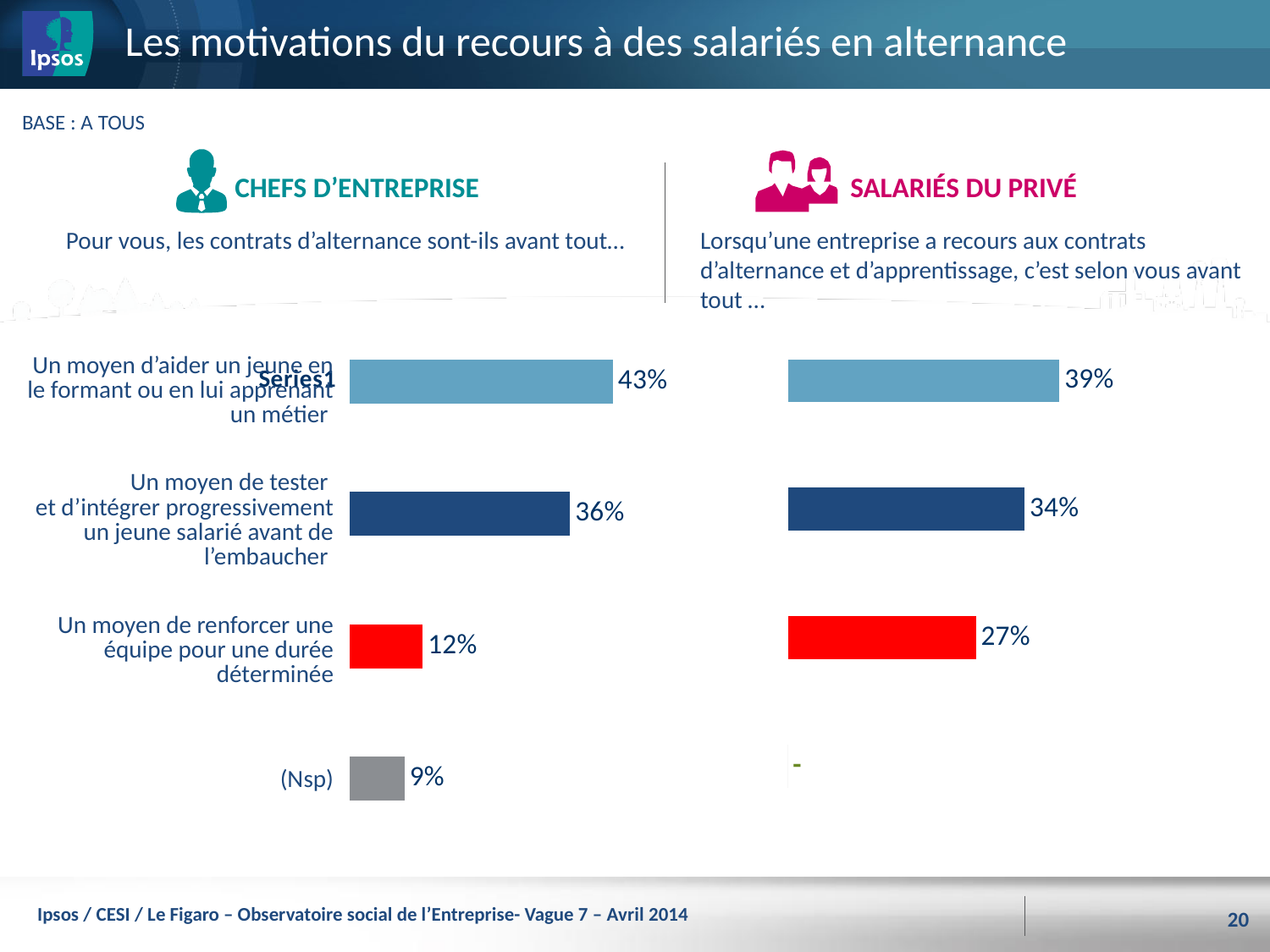
How many bars are shown in the Chefs d'entreprise chart on the left? 4 What type of chart is used on this slide? Bar chart In the Salariés du privé chart on the right, what is the value for "Un moyen de tester et d'intégrer progressivement un jeune salarié avant de l'embaucher"? 34% For "Un moyen de renforcer une équipe pour une durée déterminée", which group gives the larger value: Chefs d'entreprise or Salariés du privé? Salariés du privé In the Chefs d'entreprise chart on the left, which category has the highest value? Un moyen d'aider un jeune en le formant ou en lui apprenant un métier In the Chefs d'entreprise chart on the left, what is the value for (Nsp)? 9% In the Salariés du privé chart on the right, what is the value for "Un moyen de renforcer une équipe pour une durée déterminée"? 27% In the Chefs d'entreprise chart on the left, what is the value for "Un moyen d'aider un jeune en le formant ou en lui apprenant un métier"? 43% In the Salariés du privé chart on the right, which category has the highest value? Un moyen d'aider un jeune en le formant ou en lui apprenant un métier In the Chefs d'entreprise chart on the left, which category has the lowest value? (Nsp) In the Chefs d'entreprise chart on the left, what is the difference between "Un moyen de tester et d'intégrer progressivement un jeune salarié avant de l'embaucher" and "Un moyen de renforcer une équipe pour une durée déterminée"? 24 percentage points What is the difference between the Chefs d'entreprise value (43%) and the Salariés du privé value (39%) for "Un moyen d'aider un jeune en le formant ou en lui apprenant un métier"? 4 percentage points